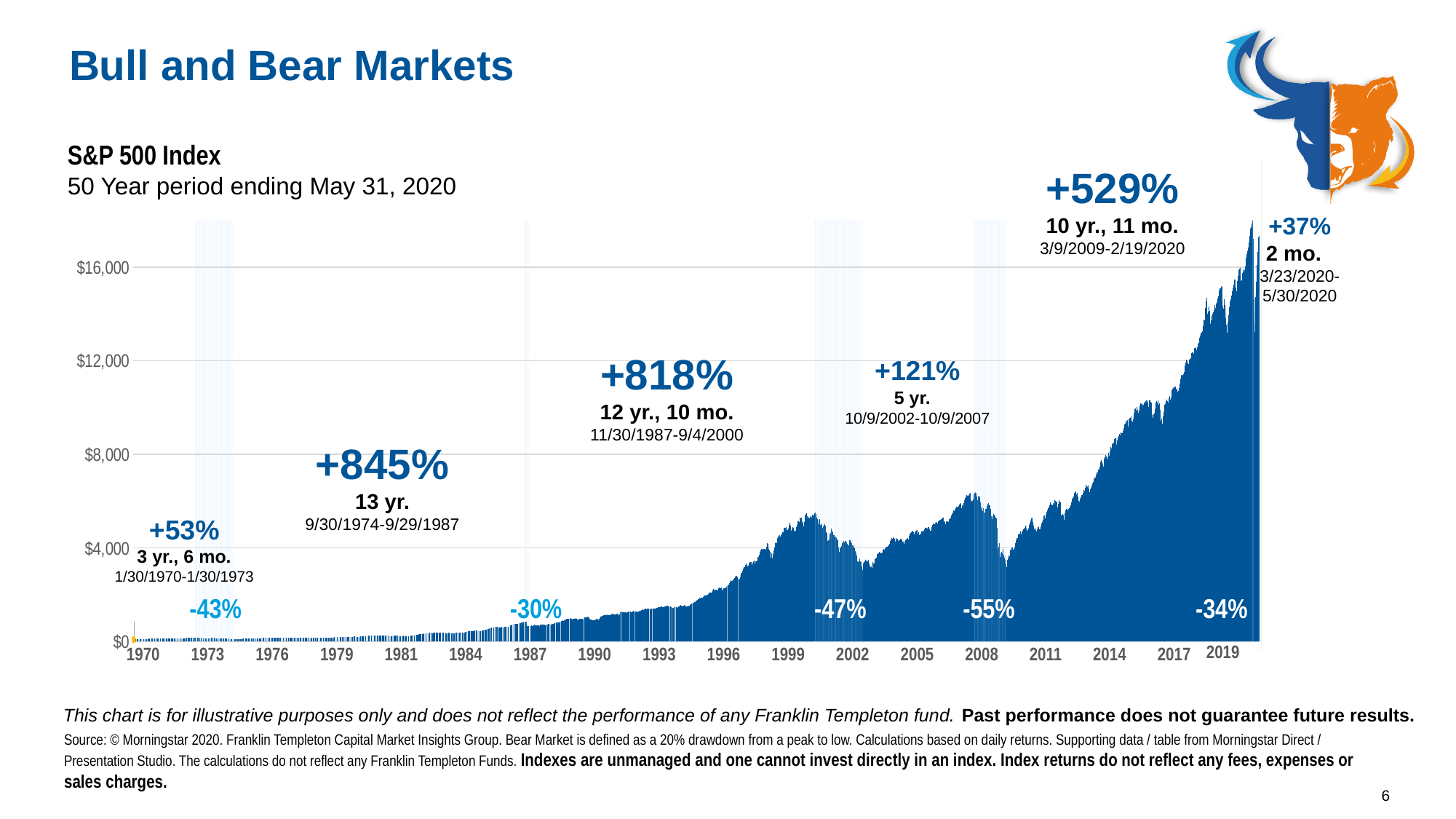
How long did the +845% bull market last according to the chart? 13 yr. What gain is shown for the bull market from 3/9/2009 to 2/19/2020? +529% Which bull market gain is larger, the one from 11/30/1987-9/4/2000 or the one from 9/30/1974-9/29/1987? 9/30/1974-9/29/1987 (+845%) Which bull market on the chart shows the smallest percentage gain? +37% (3/23/2020-5/30/2020) What type of chart is used to show the S&P 500 Index? Area chart How many bull market periods are annotated on the chart? 6 Which bear market on the chart shows the largest percentage decline? -55% Which bull market on the chart shows the largest percentage gain? +845% (9/30/1974-9/29/1987) What is the difference in percentage points between the +845% and +818% bull market gains? 27 percentage points Is the index value at its 2007 peak greater or less than $8,000? less How many bear market declines are labeled on the chart? 5 What decline is labeled for the bear market around 2008? -55%